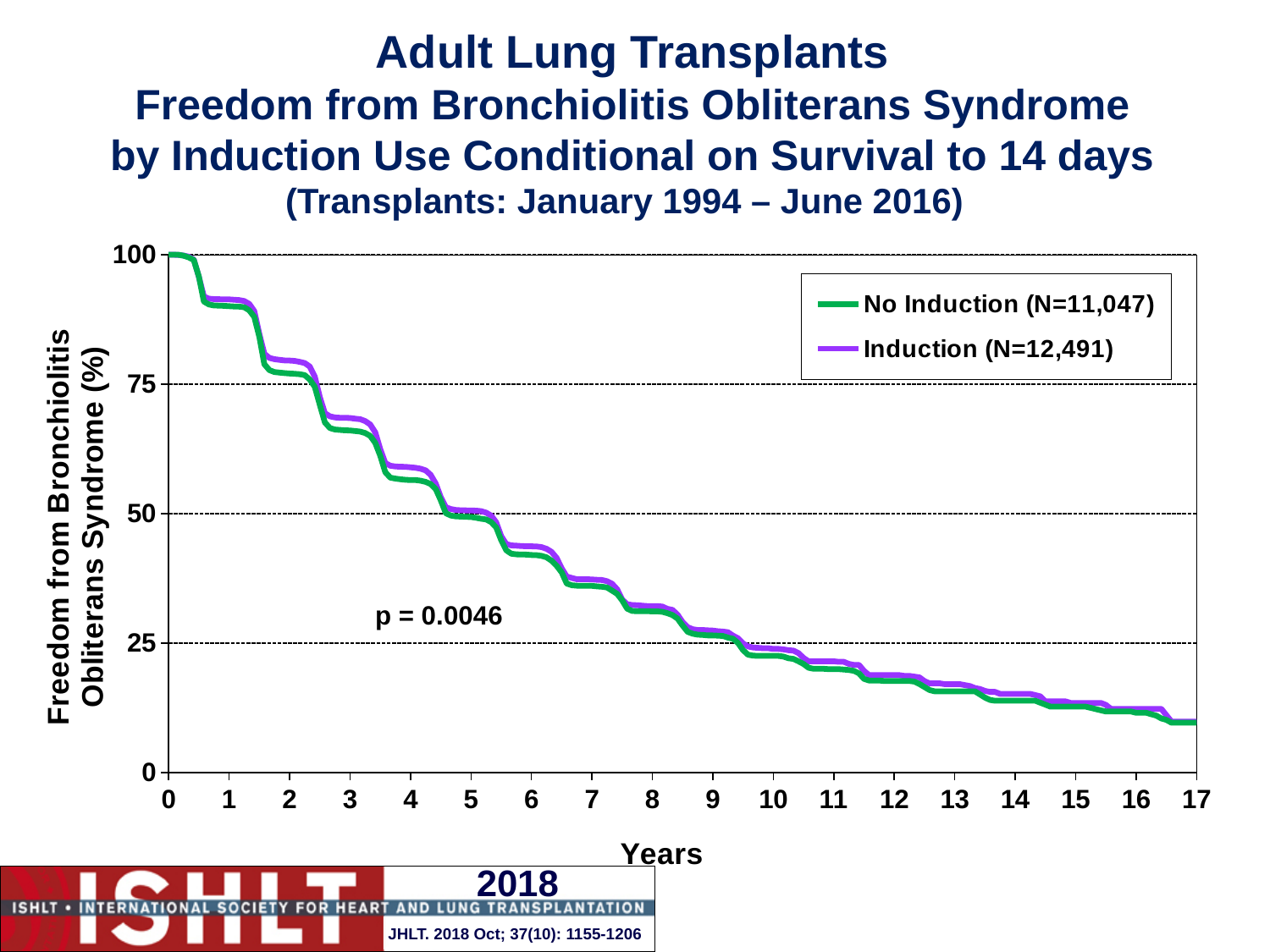
What is the N for the No Induction group shown in the legend? 11,047 Do the values for the Induction series rise or fall as years increase along the x axis? fall Is the value for the Induction series at 1 year greater or less than 75? greater Is the value for the No Induction series at 10 years greater or less than 25? less What p-value is printed on the chart? p = 0.0046 How many series does the legend list? 2 Do the values for the No Induction series rise or fall as years increase along the x axis? fall Is the value for the No Induction series at 3 years greater or less than 50? greater What kind of chart is shown on the slide? line chart